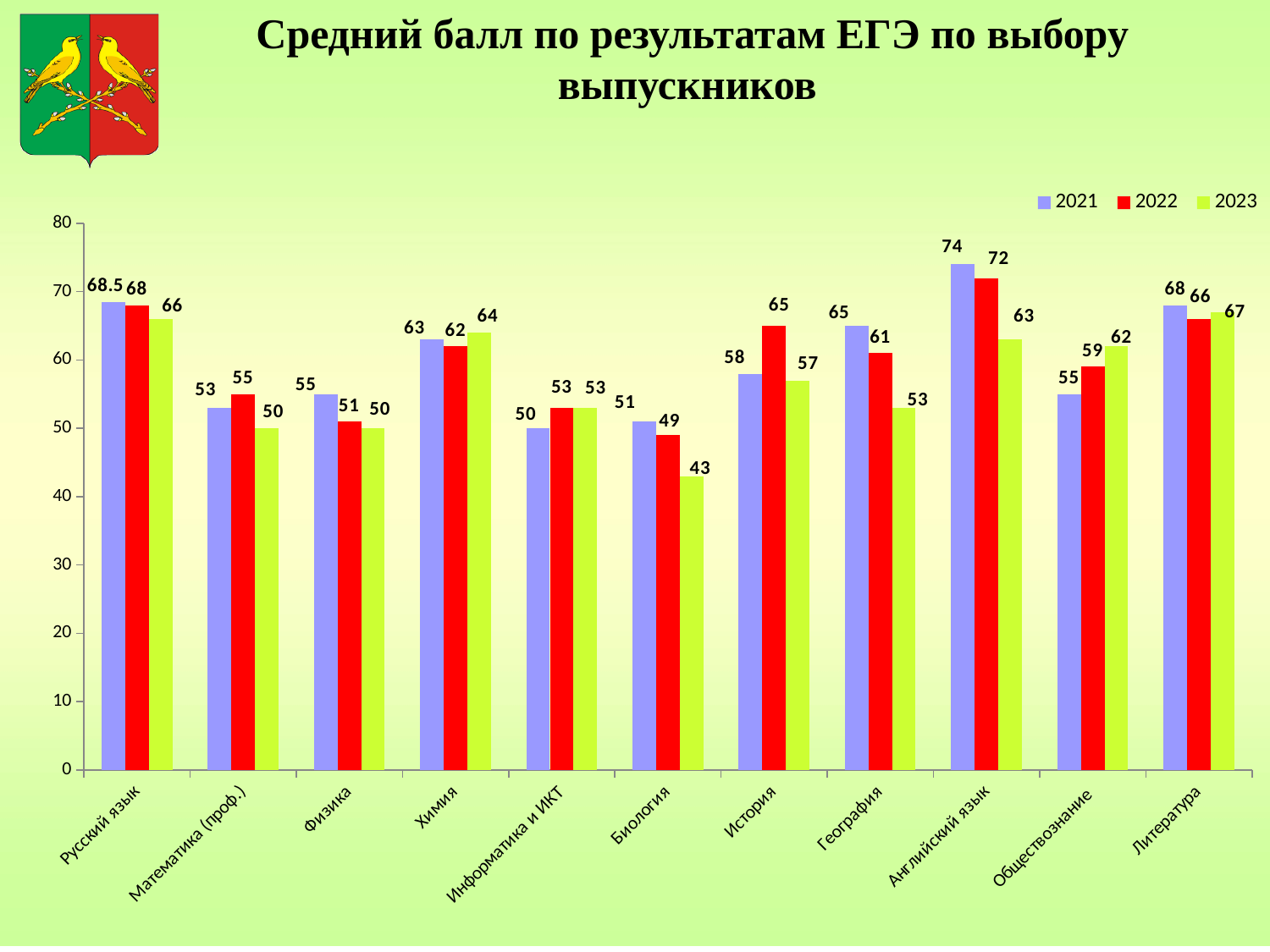
What is the 2021 value for Русский язык? 68.5 What kind of chart is shown on the slide? bar chart How many subjects are shown on the x axis? 11 What is the difference between the 2021 and 2023 values for Английский язык? 11 Which colour represents 2022 in the legend? red What is the 2023 value for Биология? 43 Which subject has the lowest 2023 value? Биология Is the 2022 value for Биология greater or less than 50? less How many series does the legend list? 3 What is the 2022 value for История? 65 Which is larger for Обществознание: the 2021 value or the 2023 value? 2023 Which subject has the highest 2021 value? Английский язык